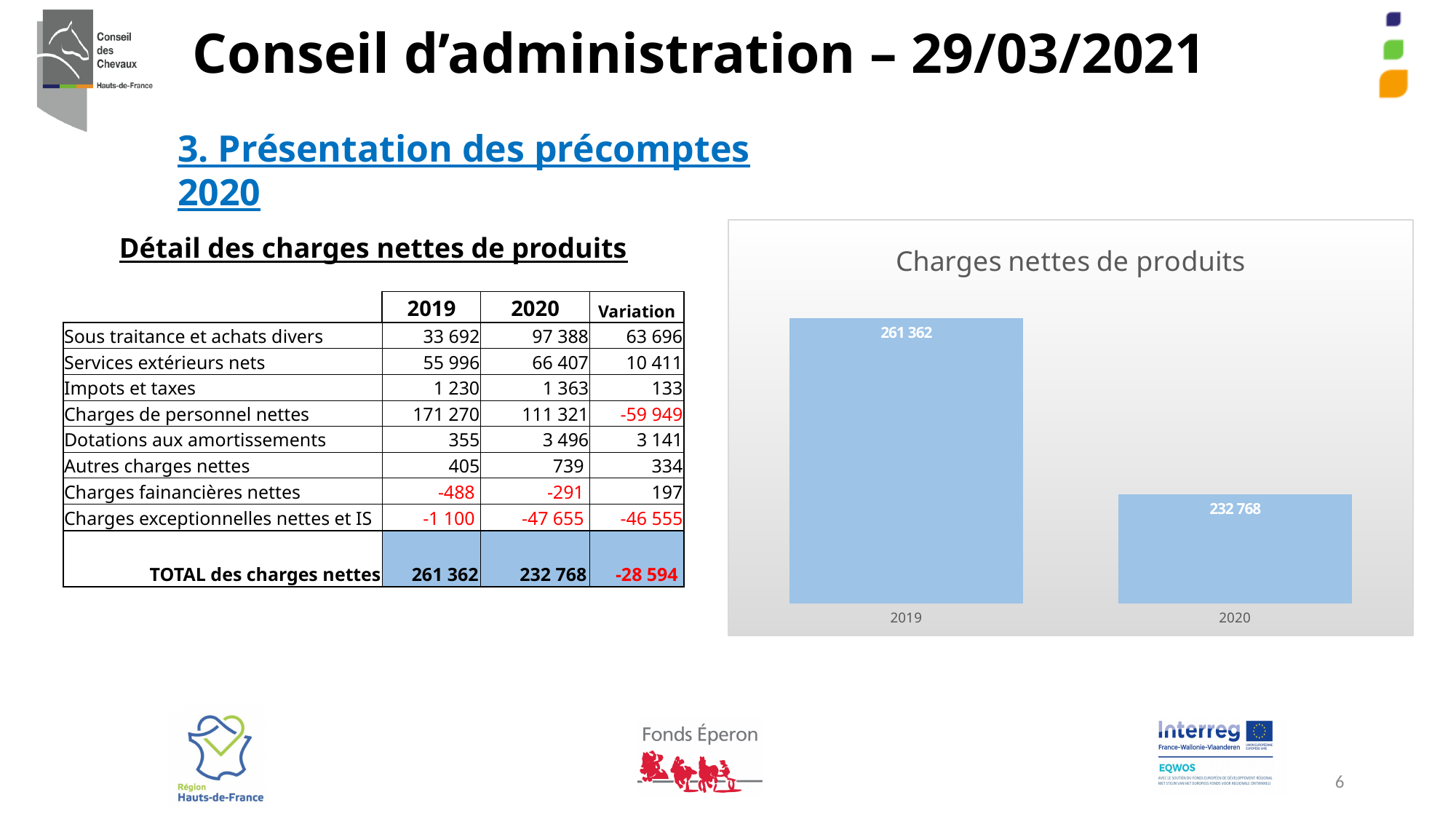
What is the value of the bar for 2020 in the 'Charges nettes de produits' chart? 232 768 What is the difference between the 2019 and 2020 values in the 'Charges nettes de produits' chart? 28 594 Which year has the lower value in the 'Charges nettes de produits' chart? 2020 How many bars are shown in the 'Charges nettes de produits' chart? 2 What is the value of the bar for 2019 in the 'Charges nettes de produits' chart? 261 362 What type of chart is 'Charges nettes de produits'? bar chart What is the title of the chart on the slide? Charges nettes de produits What colour are the bars in the 'Charges nettes de produits' chart? light blue Which year has the higher value in the 'Charges nettes de produits' chart? 2019 Do the values in the 'Charges nettes de produits' chart rise or fall from 2019 to 2020? fall In the 'Charges nettes de produits' chart, is the value for 2019 larger or smaller than the value for 2020? larger